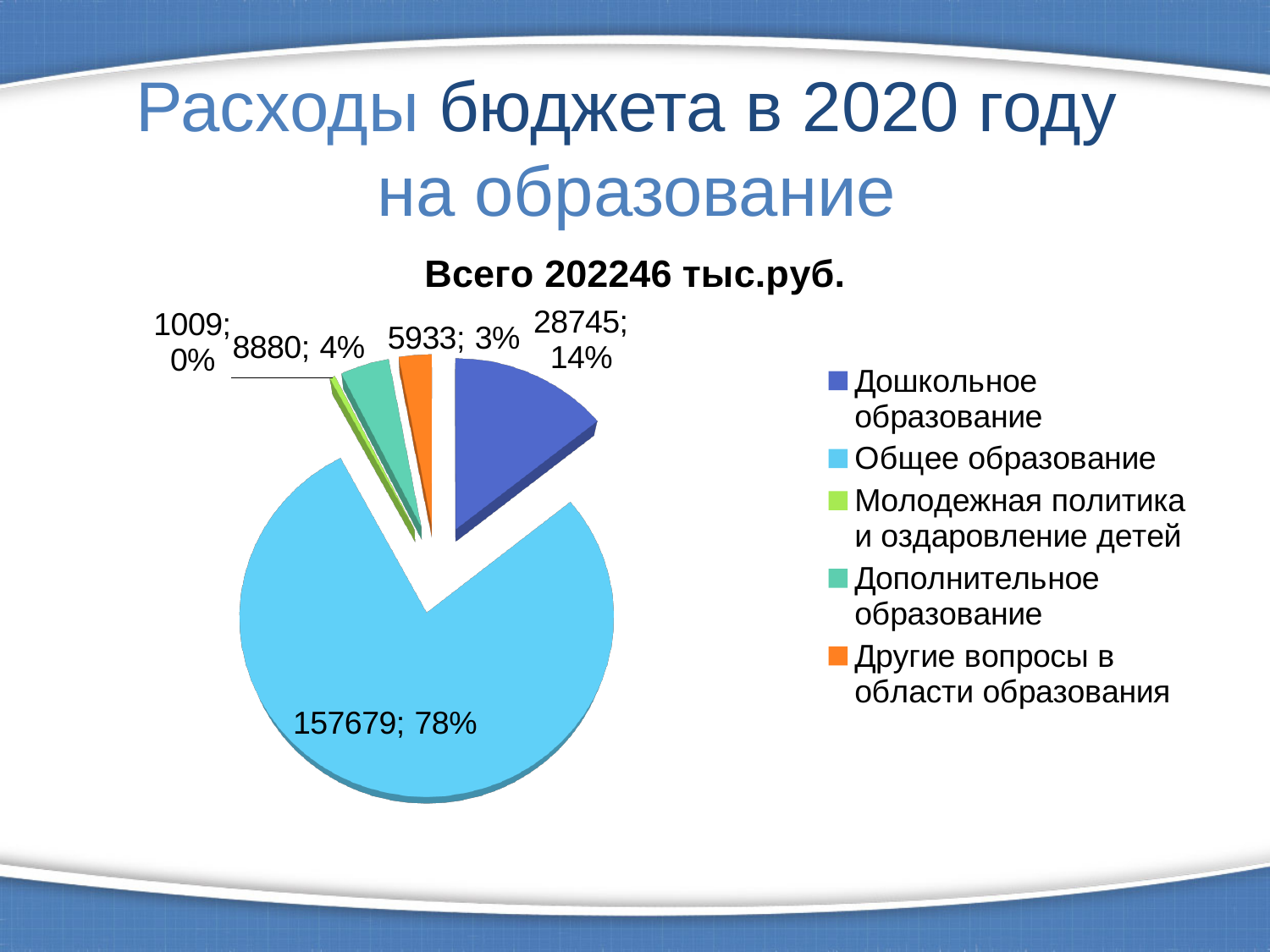
What is the value for Общее образование? 157679 What is the value for Дополнительное образование? 8880 What is the value for Другие вопросы в области образования? 5933 What kind of chart is shown on the slide? pie chart What is the value for Дошкольное образование? 28745 How many categories does the legend list? 5 Which category has the largest slice of the pie? Общее образование What is the value for Молодежная политика и оздаровление детей? 1009 What share of the pie does Общее образование take? 78% Which category has the smallest slice of the pie? Молодежная политика и оздаровление детей What is the difference between the values for Общее образование and Дошкольное образование? 128934 What share of the pie does Дошкольное образование take? 14%